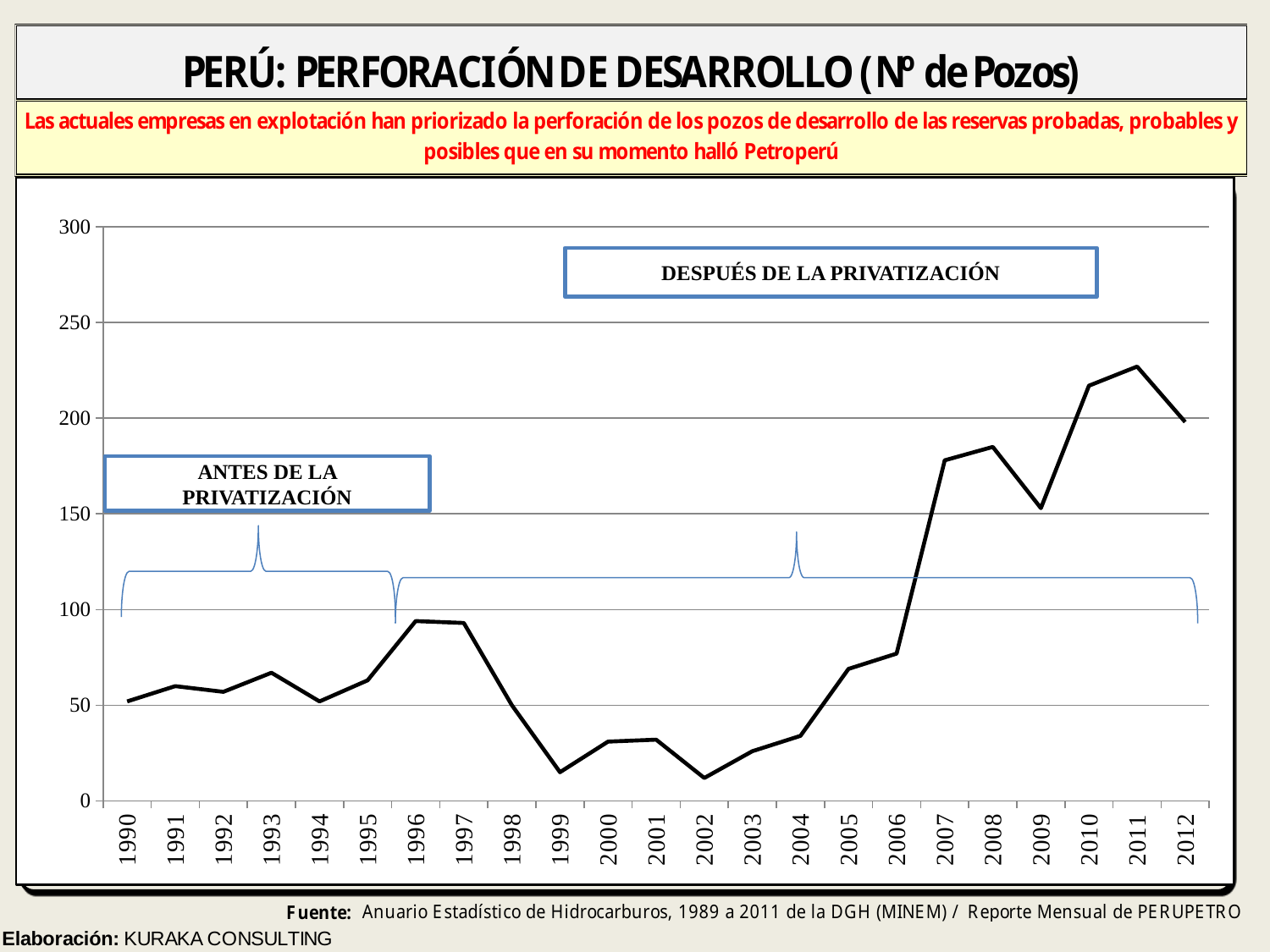
What label is shown in the box above the right-hand part of the chart? DESPUÉS DE LA PRIVATIZACIÓN What kind of chart is shown on the slide? line chart What is the title of the chart on the slide? PERÚ: PERFORACIÓN DE DESARROLLO (Nº de Pozos) Is the value for 1999 greater or less than 50? less Which year has the lowest number of development wells in the chart? 2002 Which year has the highest number of development wells in the chart? 2011 Do the values rise or fall from 2006 to 2008? rise Is the value for 1996 greater or less than 100? less Which year has a higher value, 2007 or 2006? 2007 How many years are plotted along the x axis of the chart? 23 Is the value for 2011 greater or less than 200? greater